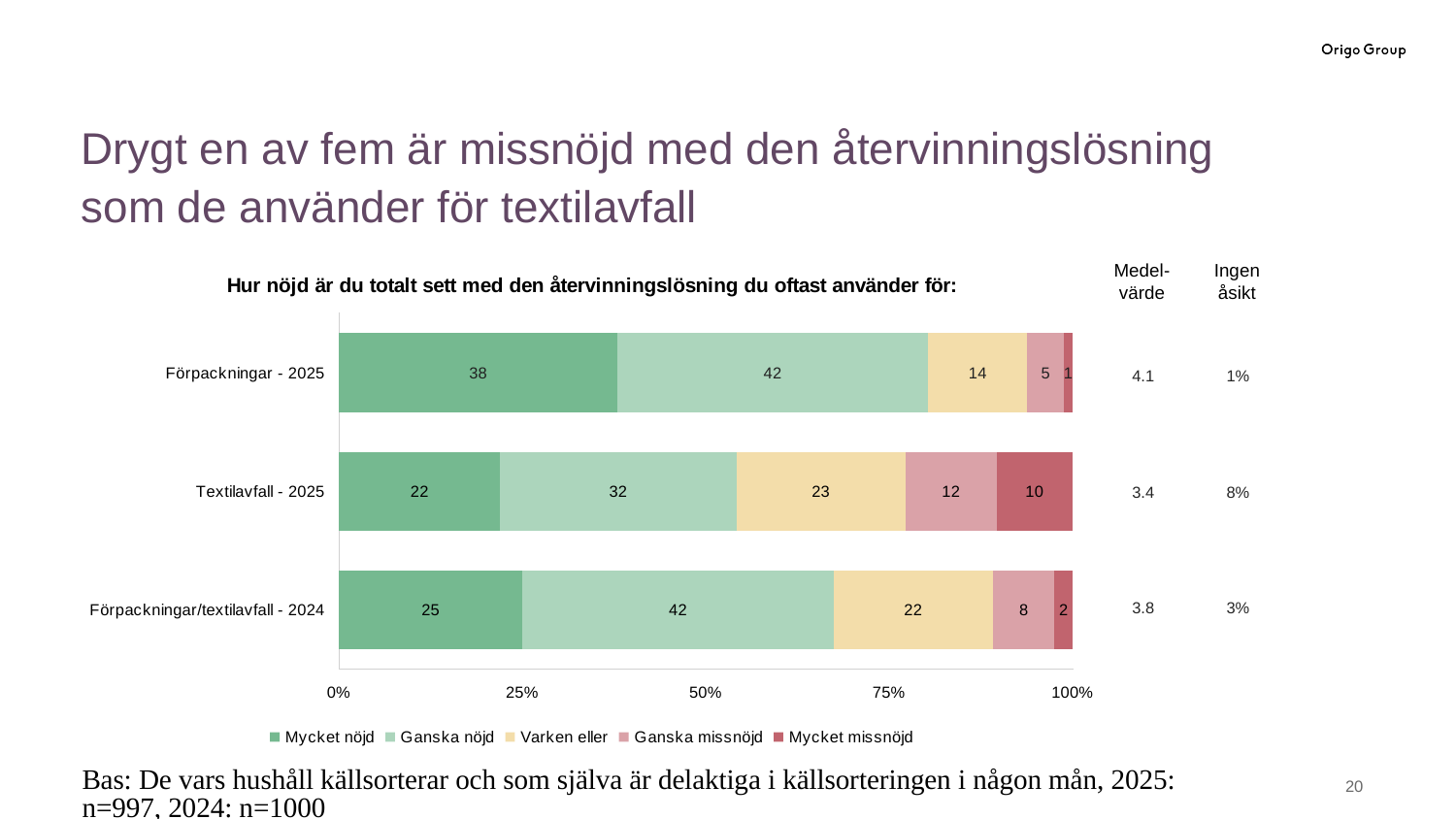
Which is larger: the 'Varken eller' value for 'Textilavfall - 2025' or for 'Förpackningar - 2025'? Textilavfall - 2025 What is the value of 'Ganska nöjd' for 'Förpackningar - 2025'? 42 What kind of chart is shown on the slide? Stacked bar chart What is the value of 'Mycket nöjd' for 'Textilavfall - 2025'? 22 Which category has the highest 'Mycket nöjd' value? Förpackningar - 2025 How many categories (bars) are shown in the chart? 3 How many series does the legend list? 5 Which category has the lowest 'Ganska missnöjd' value? Förpackningar - 2025 What is the 'Medelvärde' shown for 'Textilavfall - 2025'? 3.4 What is the value of 'Mycket missnöjd' for 'Textilavfall - 2025'? 10 What is the value of 'Varken eller' for 'Förpackningar/textilavfall - 2024'? 22 What is the difference between the 'Mycket nöjd' values for 'Förpackningar - 2025' and 'Textilavfall - 2025'? 16